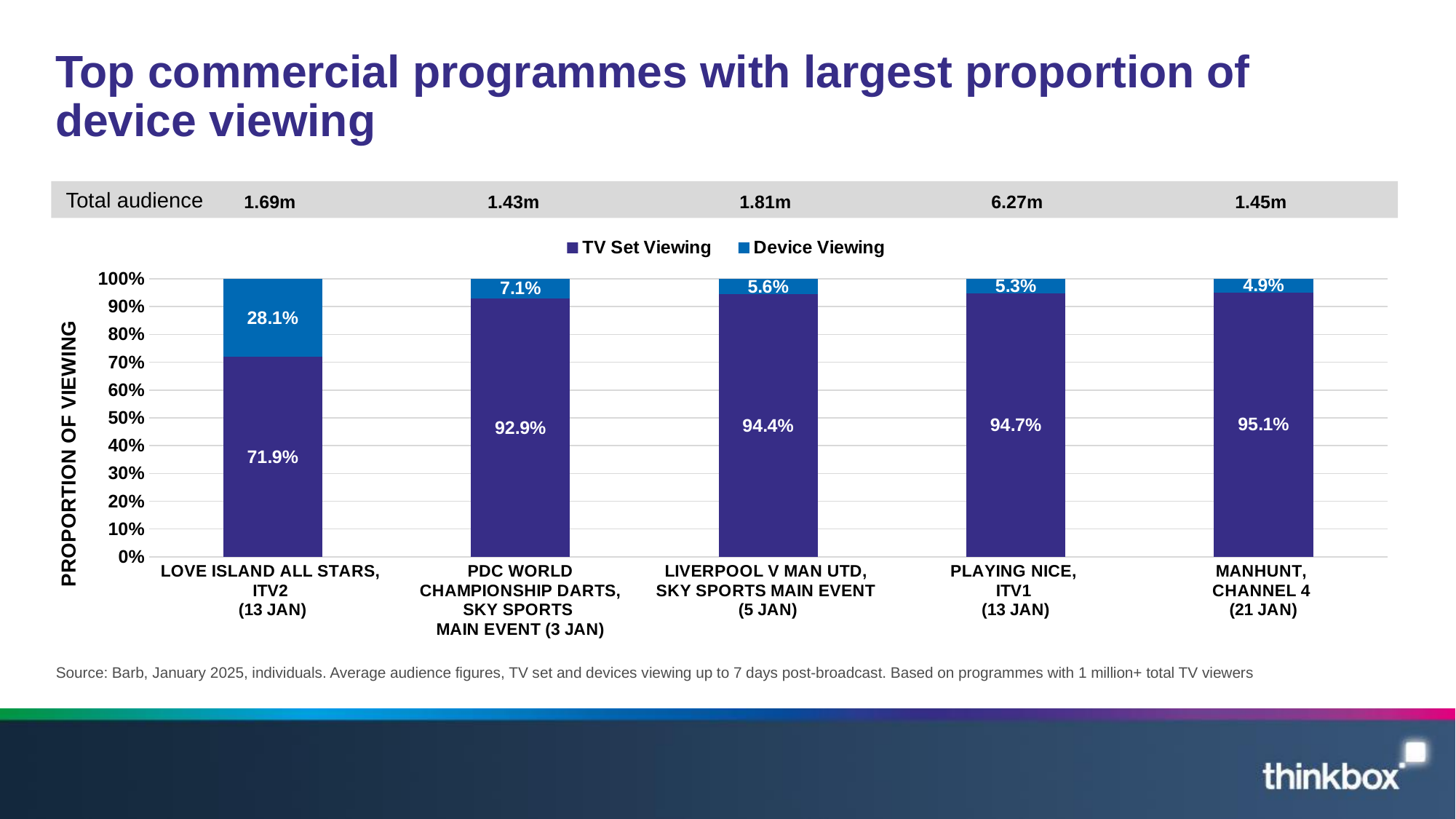
What is the total audience shown for Playing Nice, ITV1? 6.27m Which has a larger Device Viewing share: Liverpool v Man Utd or Playing Nice? Liverpool v Man Utd What kind of chart is shown on the slide? Stacked bar chart Which programme has the lowest TV Set Viewing share? Love Island All Stars, ITV2 (13 Jan) What is the difference between the Device Viewing shares of Love Island All Stars and PDC World Championship Darts? 21.0% How many series does the legend list? 2 What is the TV Set Viewing share for PDC World Championship Darts, Sky Sports Main Event (3 Jan)? 92.9% What is the Device Viewing share for Manhunt, Channel 4 (21 Jan)? 4.9% Which programme has the highest Device Viewing share? Love Island All Stars, ITV2 (13 Jan) What is the Device Viewing share for Love Island All Stars, ITV2 (13 Jan)? 28.1% What is the TV Set Viewing share for Playing Nice, ITV1 (13 Jan)? 94.7% How many programmes are shown on the chart? 5